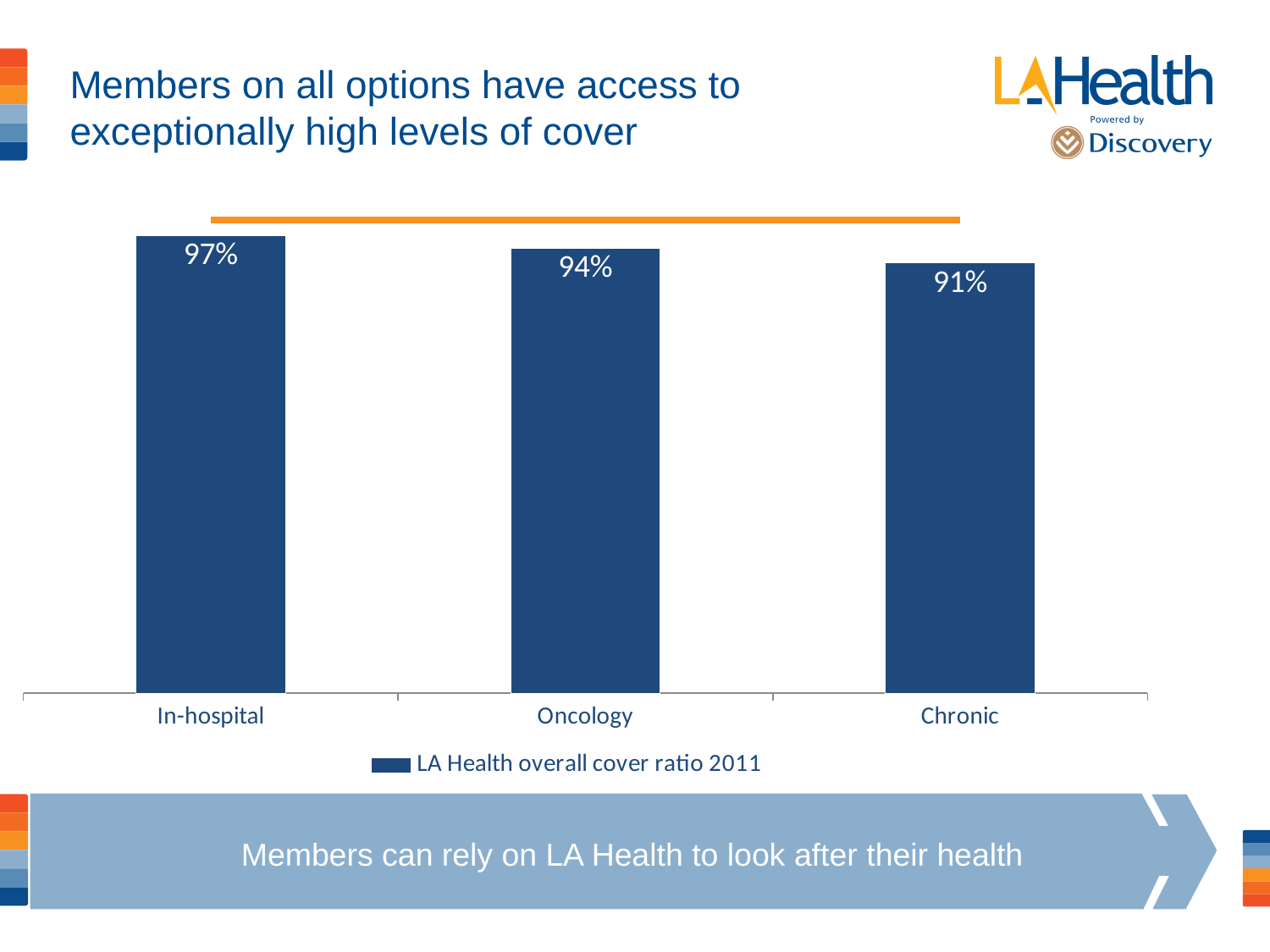
What is the LA Health overall cover ratio 2011 for Oncology? 94% How many series does the legend list? 1 What is the difference between the In-hospital and Chronic cover ratios? 6% Which has a higher cover ratio, Oncology or Chronic? Oncology Which category has the lowest cover ratio? Chronic What is the LA Health overall cover ratio 2011 for In-hospital? 97% What is the legend entry for the series shown in the chart? LA Health overall cover ratio 2011 Which category has the highest cover ratio? In-hospital What is the LA Health overall cover ratio 2011 for Chronic? 91% How many categories are shown on the x axis of the chart? 3 What is the difference between the Oncology and Chronic cover ratios? 3% What kind of chart is shown on the slide? Bar chart